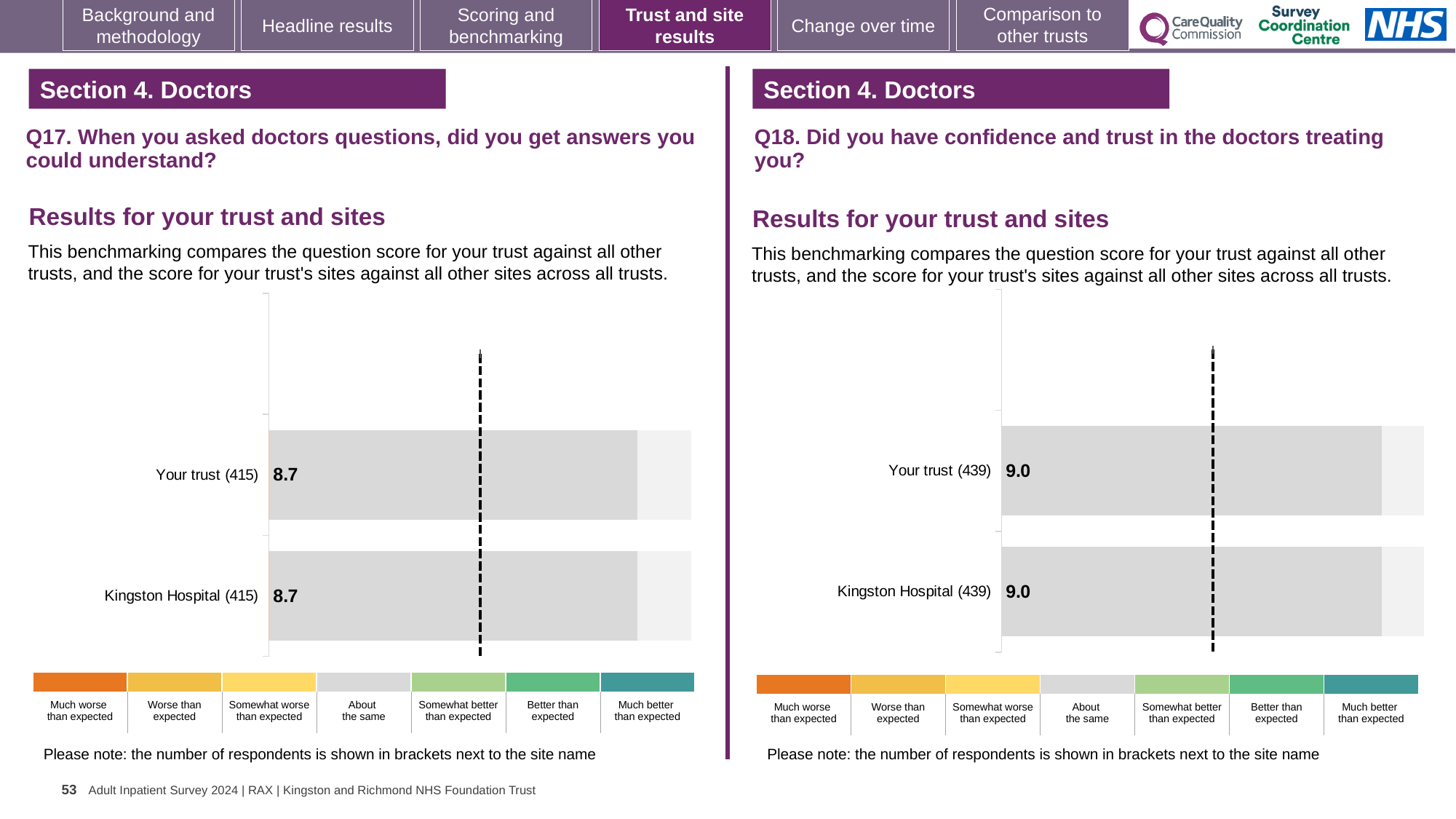
How many bars are plotted in the Q17 chart on the left? 2 In the Q17 chart on the left, what is the score for Kingston Hospital? 8.7 In the Q18 chart on the right, what is the score for Your trust? 9.0 In the Q17 chart on the left, how many respondents are shown in brackets next to Your trust? 415 In the Q18 chart on the right, how many respondents are shown in brackets next to Kingston Hospital? 439 In the Q18 chart on the right, what is the score for Kingston Hospital? 9.0 In the Q17 chart on the left, what is the score for Your trust? 8.7 How many benchmark categories does the colour key below the Q18 chart on the right list? 7 What is the difference between the Your trust score in the Q18 chart and the Your trust score in the Q17 chart? 0.3 How many bars are plotted in the Q18 chart on the right? 2 What kind of chart is used for the Q17 results on the left? Bar chart In the colour key below the Q17 chart on the left, what colour represents 'About the same'? Grey